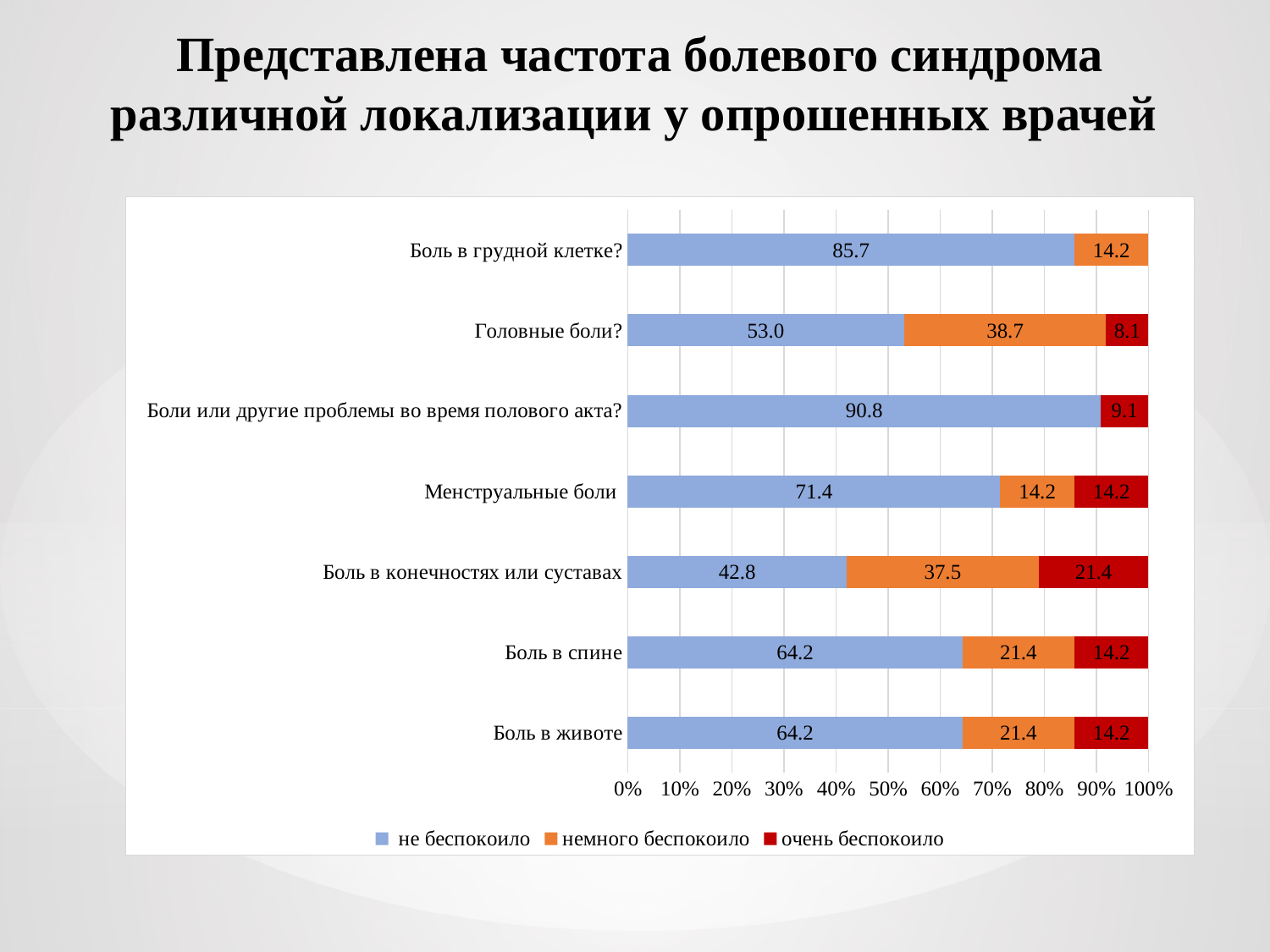
What is the value of "не беспокоило" for "Головные боли?"? 53.0 How many categories are shown on the chart? 7 What is the value of "очень беспокоило" for "Менструальные боли"? 14.2 How many series does the legend list? 3 What colour represents "очень беспокоило" in the legend? Red What is the difference between the "не беспокоило" values for "Боль в грудной клетке?" and "Головные боли?"? 32.7 Which category has the lowest value for "не беспокоило"? Боль в конечностях или суставах Which category has the highest value for "не беспокоило"? Боли или другие проблемы во время полового акта? Which has the larger "очень беспокоило" value: "Боль в конечностях или суставах" or "Головные боли?"? Боль в конечностях или суставах What kind of chart is shown on the slide? Stacked bar chart What is the value of "немного беспокоило" for "Боль в конечностях или суставах"? 37.5 What is the value of "немного беспокоило" for "Боль в спине"? 21.4